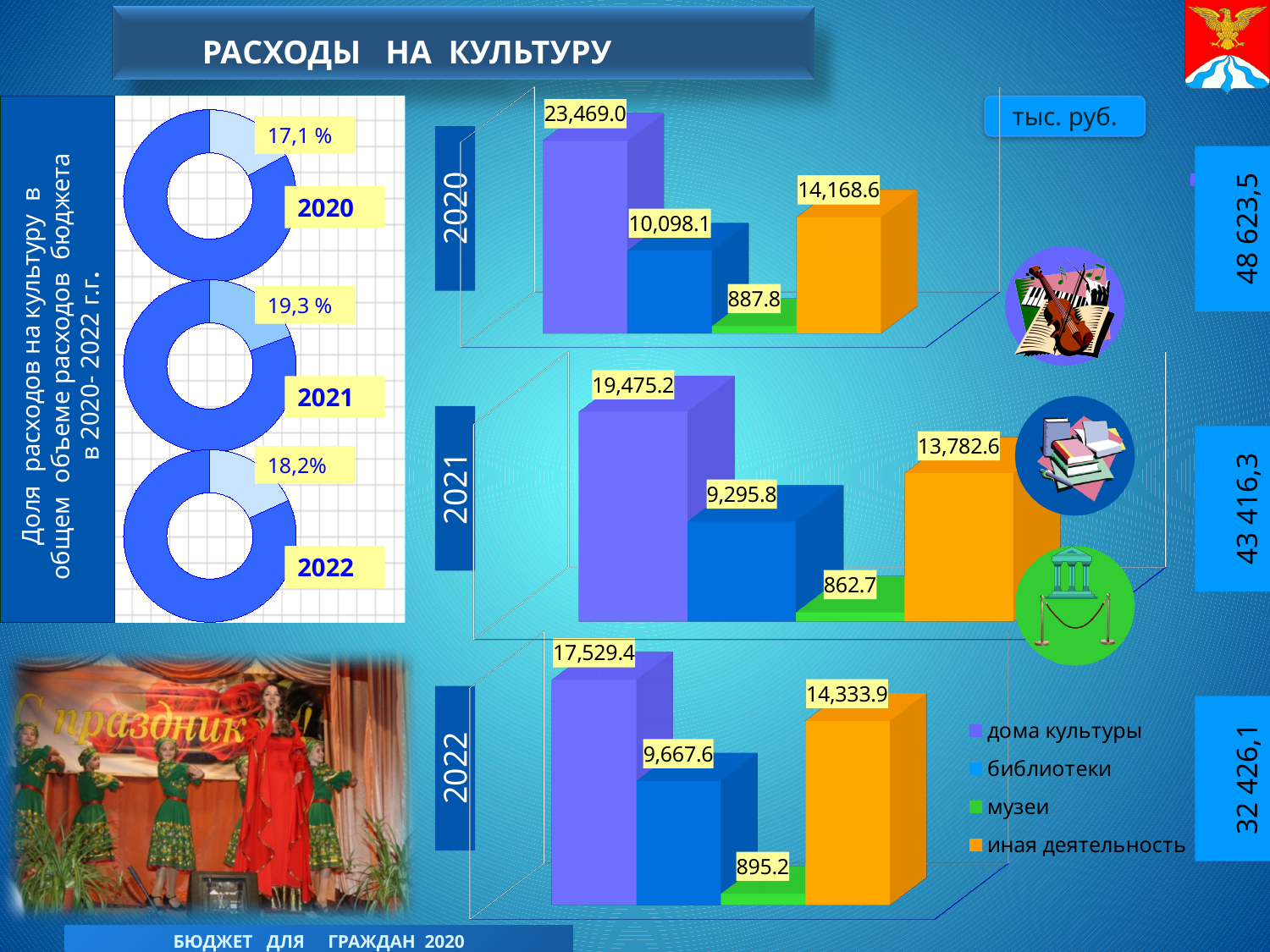
What kind of chart is used to show the expenses by category for each year? bar chart In the 2021 bar chart, which category has the highest value? дома культуры In the 2022 bar chart, what is the difference between дома культуры and библиотеки? 7,861.8 In the 2020 bar chart, what is the value for дома культуры? 23,469.0 In the donut charts on the left, what share of total budget expenses do culture expenses make up in 2021? 19,3 % In the 2022 bar chart, what is the value for иная деятельность? 14,333.9 In the 2022 bar chart, what is the value for музеи? 895.2 In the 2021 bar chart, what is the value for библиотеки? 9,295.8 How many series does the legend of the bar charts list? 4 In the 2021 bar chart, which is larger: библиотеки or иная деятельность? иная деятельность In the donut charts on the left, which year has the lowest share of culture expenses? 2020 In the 2020 bar chart, which category has the lowest value? музеи